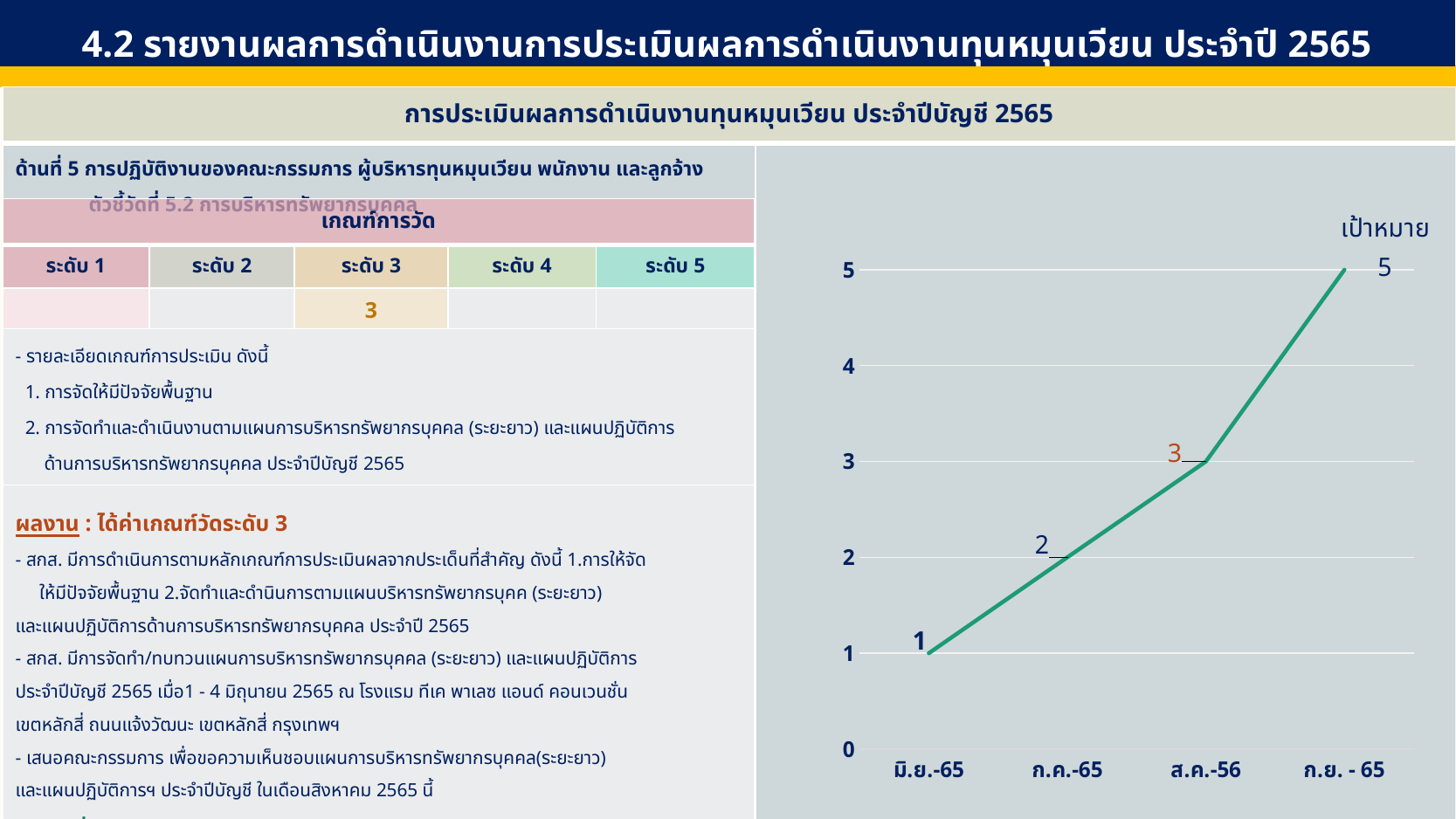
What type of chart is shown on the right side of the slide? line chart What is the value plotted for ก.ย. - 65? 5 Do the values rise or fall from left to right along the x axis? rise What is the value plotted for ก.ค.-65? 2 What is the value plotted for มิ.ย.-65? 1 How many categories are shown on the x axis of the chart? 4 Which category on the x axis has the highest value? ก.ย. - 65 What is the value plotted for ส.ค.-56? 3 What label is written above the last data point of the line? เป้าหมาย What is the difference between the value for ก.ย. - 65 and the value for ส.ค.-56? 2 Which is larger, the value for ก.ค.-65 or the value for ส.ค.-56? ส.ค.-56 Which category on the x axis has the lowest value? มิ.ย.-65